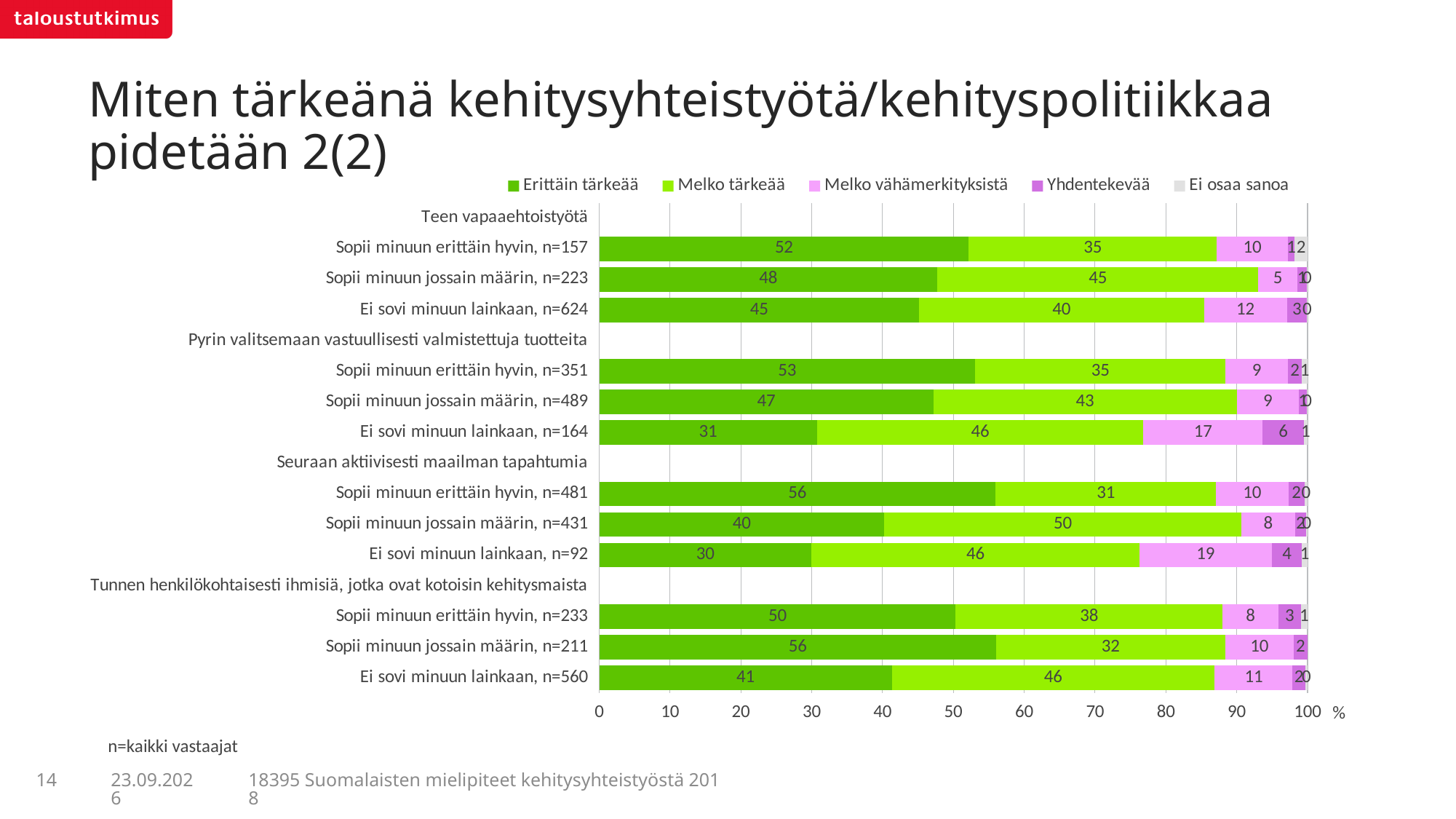
What is the difference between the 'Erittäin tärkeää' values for 'Sopii minuun erittäin hyvin, n=481' and 'Ei sovi minuun lainkaan, n=92' under 'Seuraan aktiivisesti maailman tapahtumia'? 26 Which is larger: the 'Erittäin tärkeää' value for 'Sopii minuun erittäin hyvin, n=351' or for 'Sopii minuun jossain määrin, n=489' under 'Pyrin valitsemaan vastuullisesti valmistettuja tuotteita'? Sopii minuun erittäin hyvin, n=351 How many bars (respondent groups) are plotted in the chart? 12 What is the 'Melko tärkeää' value for 'Sopii minuun jossain määrin, n=431' under 'Seuraan aktiivisesti maailman tapahtumia'? 50 How many series does the legend list? 5 What type of chart is shown on the slide? Stacked bar chart Which legend entry is shown in grey? Ei osaa sanoa What is the 'Melko vähämerkityksistä' value for 'Ei sovi minuun lainkaan, n=164' under 'Pyrin valitsemaan vastuullisesti valmistettuja tuotteita'? 17 Is the 'Erittäin tärkeää' value for 'Ei sovi minuun lainkaan, n=560' greater or less than 50? less Which respondent group has the highest 'Melko vähämerkityksistä' value? Ei sovi minuun lainkaan, n=92 What is the 'Yhdentekevää' value for 'Ei sovi minuun lainkaan, n=92' under 'Seuraan aktiivisesti maailman tapahtumia'? 4 What is the 'Erittäin tärkeää' value for 'Sopii minuun erittäin hyvin, n=157' under 'Teen vapaaehtoistyötä'? 52